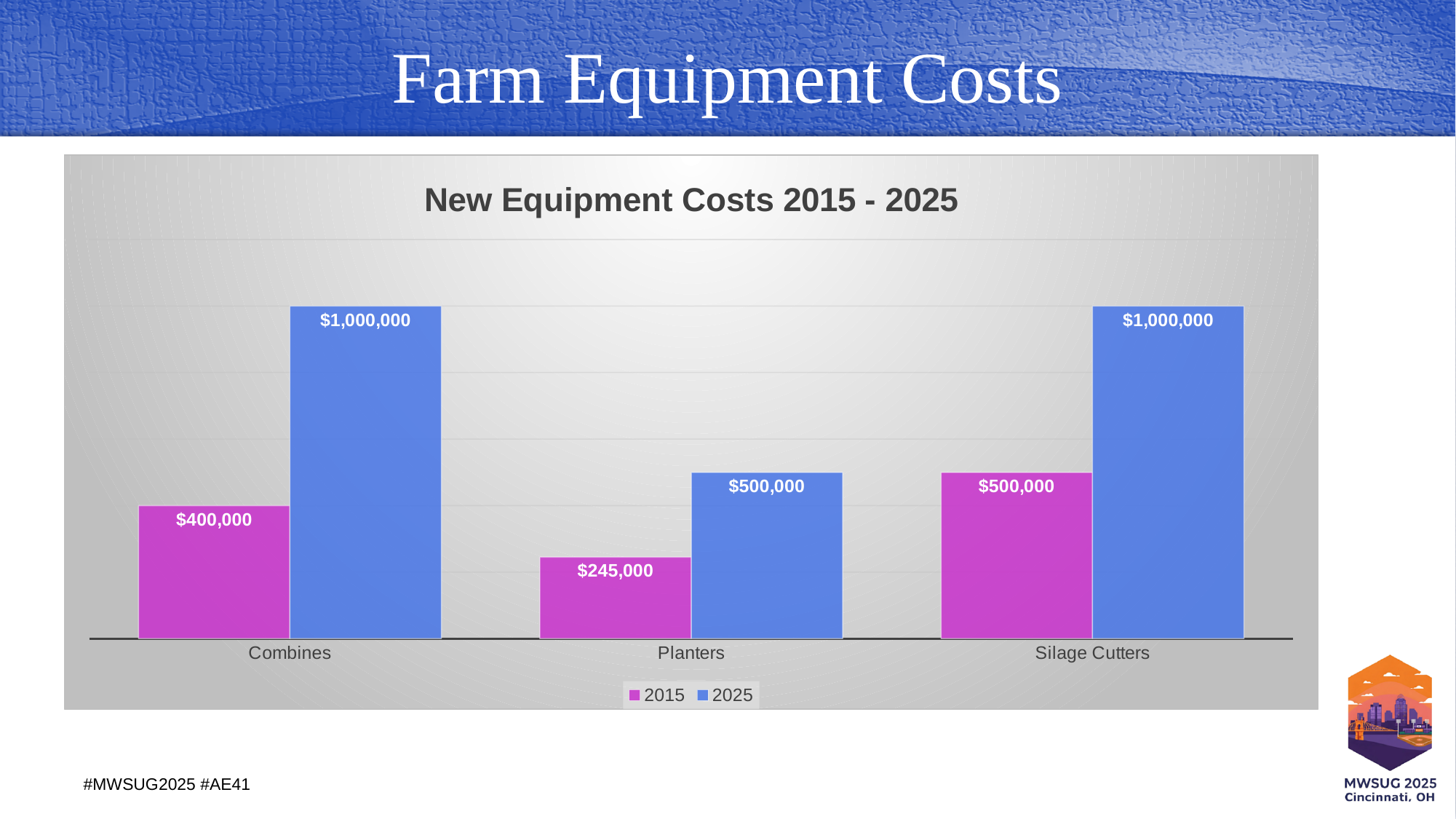
Which category has the lowest 2015 value? Planters What is the difference between the 2025 and 2015 values for Combines? $600,000 Which is larger, the 2015 value for Combines or the 2015 value for Silage Cutters? Silage Cutters What is the difference between the 2025 and 2015 values for Planters? $255,000 What is the 2015 value for Combines? $400,000 How many categories are shown on the x axis? 3 What is the 2025 value for Planters? $500,000 Which category has the lowest 2025 value? Planters How many series does the legend list? 2 What type of chart is shown? Bar chart What is the 2015 value for Silage Cutters? $500,000 What is the 2025 value for Combines? $1,000,000